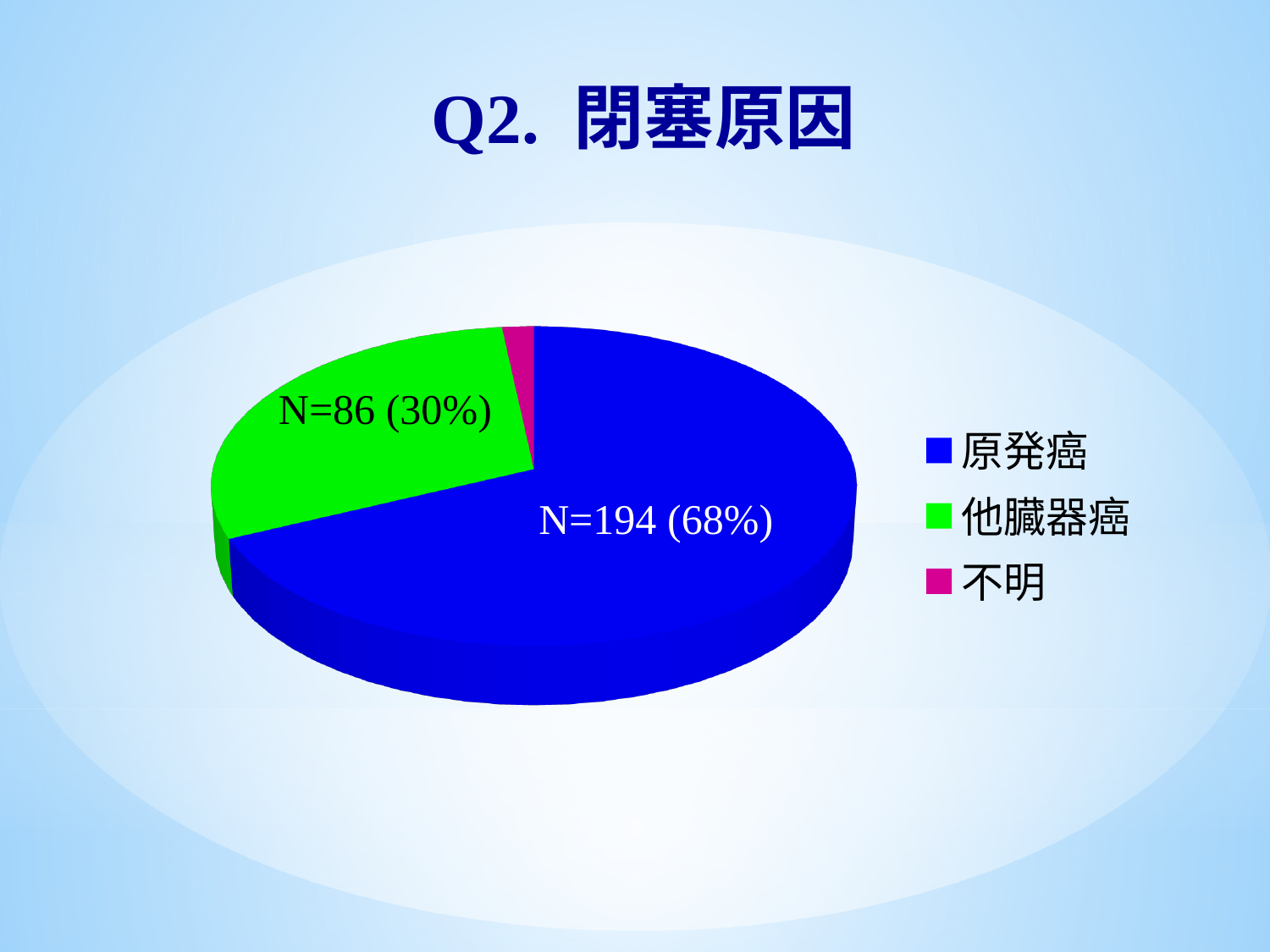
What is the title of the slide? Q2. 閉塞原因 What share of the pie does 原発癌 represent? 68% What is the difference in N between 原発癌 and 他臓器癌? 108 What share of the pie does 他臓器癌 represent? 30% What is the value shown for 他臓器癌 in the pie chart? N=86 (30%) What kind of chart is shown on the slide? Pie chart Which is larger, the slice for 原発癌 or the slice for 他臓器癌? 原発癌 How many categories are shown in the pie chart? 3 How many entries does the legend list? 3 What is the value shown for 原発癌 in the pie chart? N=194 (68%) Which category has the largest slice of the pie? 原発癌 Which category has the smallest slice of the pie? 不明